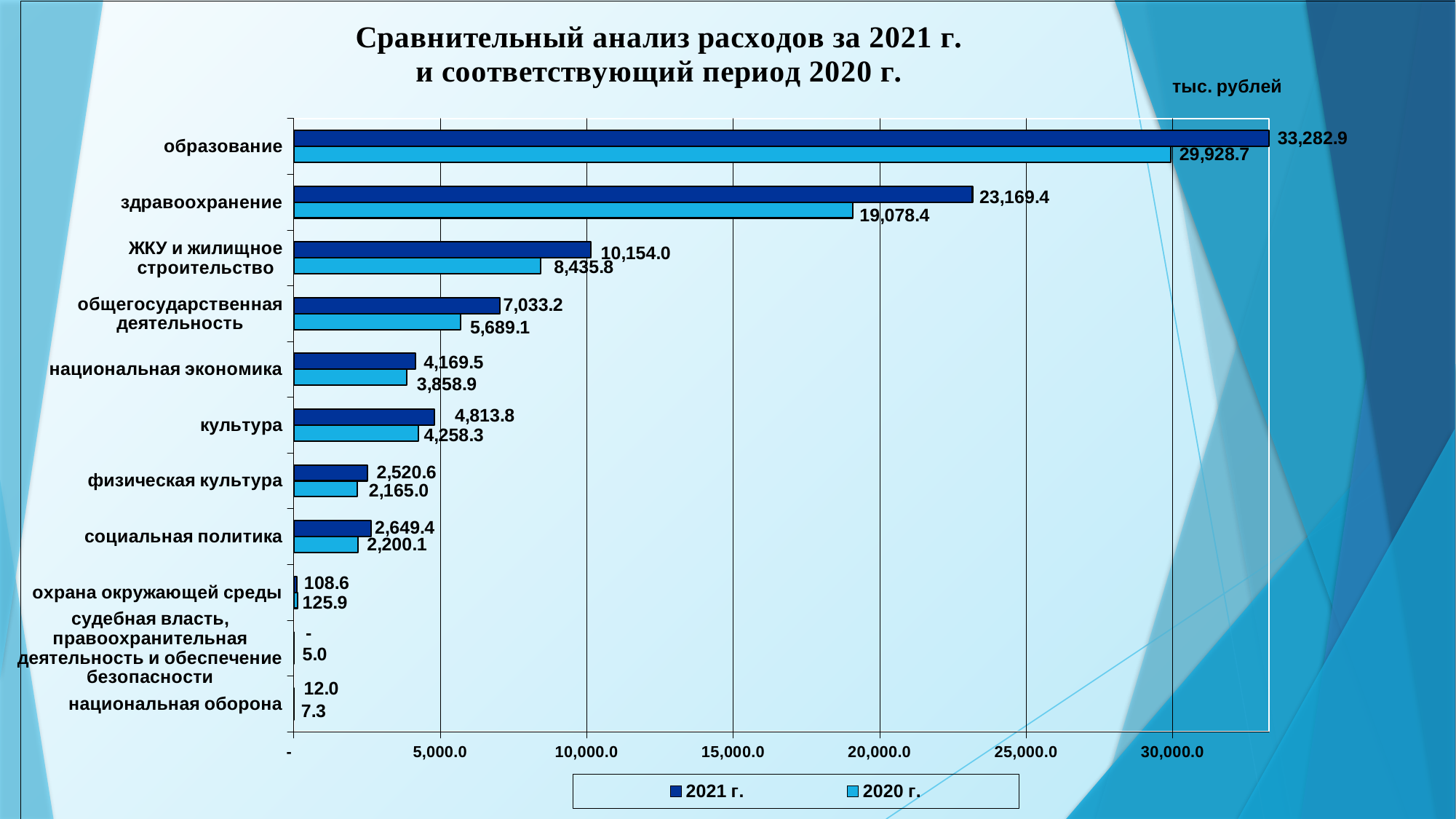
Which category has the lowest value in 2020 г.? судебная власть, правоохранительная деятельность и обеспечение безопасности What is the value for ЖКУ и жилищное строительство in 2021 г.? 10,154.0 How many series does the legend list? 2 How many categories are shown on the chart? 11 What type of chart is shown on the slide? bar chart Which category has the highest value in 2021 г.? образование What is the value for образование in 2021 г.? 33,282.9 What is the value for здравоохранение in 2020 г.? 19,078.4 What is the value for охрана окружающей среды in 2020 г.? 125.9 Which is larger for культура: the 2021 г. value or the 2020 г. value? 2021 г. What is the difference between the 2021 г. and 2020 г. values for образование? 3,354.2 What unit is indicated for the values on the chart? тыс. рублей